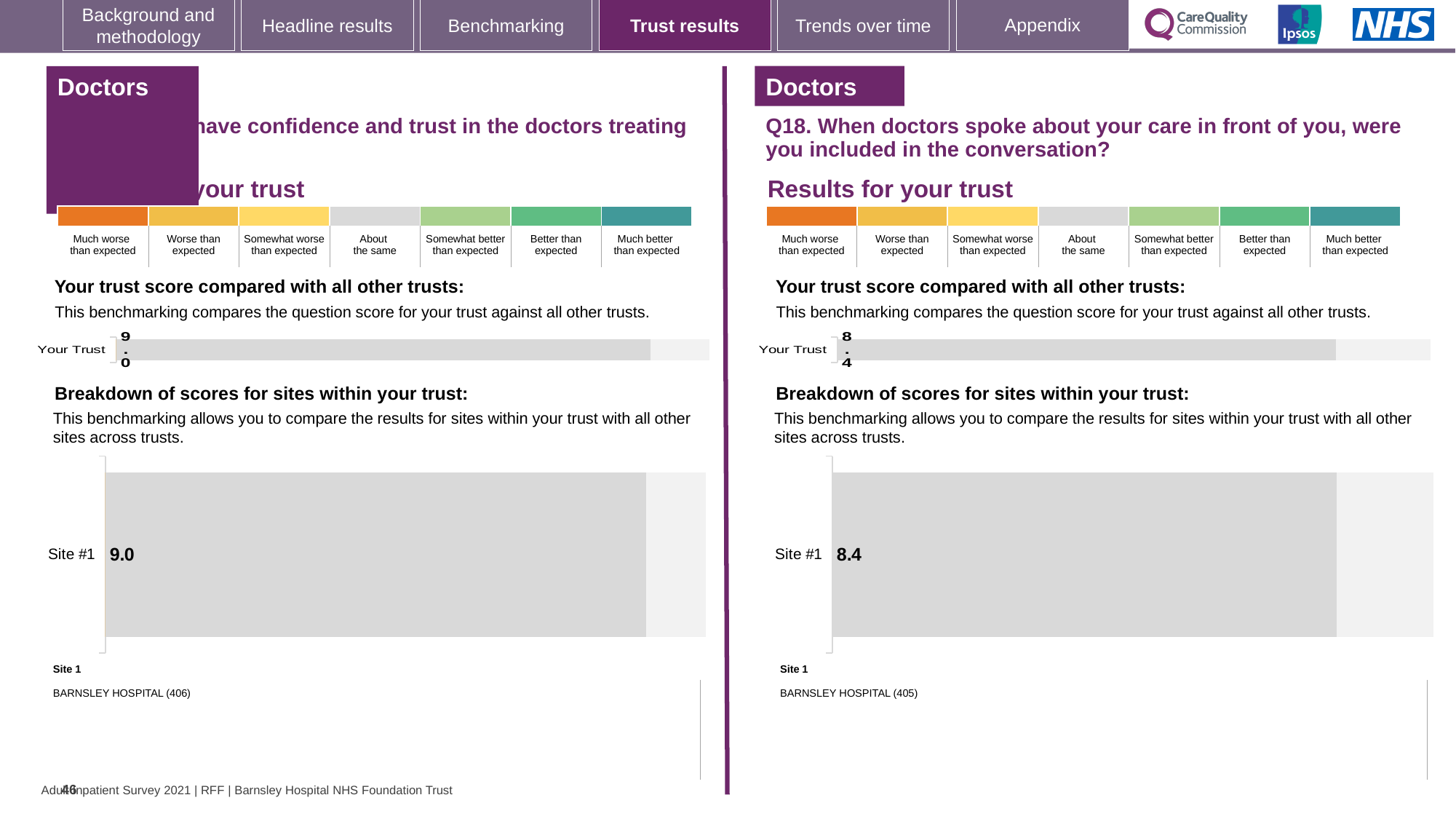
Which is larger: the Your Trust score on the left-hand chart or the Your Trust score on the right-hand chart (Q18)? Left-hand chart On the left-hand chart, what is the score shown for Your Trust? 9.0 What is the difference between the Site #1 score on the left-hand chart and the Site #1 score on the right-hand chart (Q18)? 0.6 On the right-hand chart (Q18), which hospital is listed as Site 1? BARNSLEY HOSPITAL (405) On the right-hand chart (Q18), what is the score shown for Your Trust? 8.4 Which is larger: the Site #1 score on the left-hand chart or the Site #1 score on the right-hand chart (Q18)? Left-hand chart On the left-hand chart, what is the score shown for Site #1? 9.0 What is the difference between the Your Trust score on the left-hand chart and the Your Trust score on the right-hand chart (Q18)? 0.6 How many sites are shown in the breakdown of scores on the right-hand chart (Q18)? 1 On the left-hand chart, which hospital is listed as Site 1? BARNSLEY HOSPITAL (406) What kind of chart is used to show the Site #1 score on the right-hand side (Q18)? Bar chart On the right-hand chart (Q18), what is the score shown for Site #1? 8.4